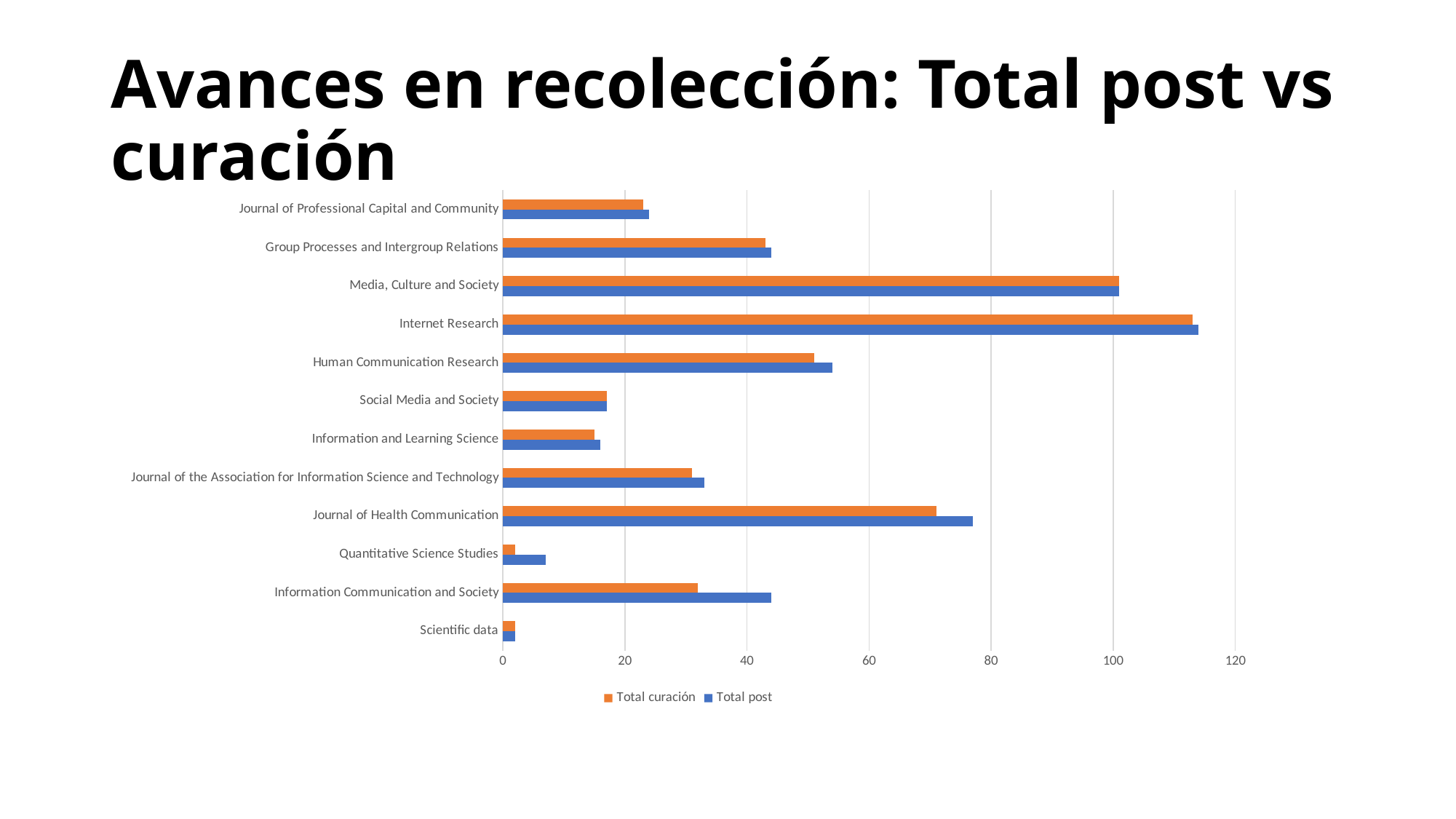
Which is larger: the Total post value for Human Communication Research or for Group Processes and Intergroup Relations? Human Communication Research Which journal has the highest Total curación value? Internet Research For Quantitative Science Studies, which is larger: Total post or Total curación? Total post Is the Total post value for Journal of Health Communication greater or less than 60? greater What kind of chart is shown on the slide? Bar chart Which colour represents the Total curación series? Orange Which journal has the lowest Total post value? Scientific data How many series does the legend list? 2 Is the Total curación value for Social Media and Society greater or less than 20? less Is the Total post value for Internet Research greater or less than 100? greater Which journal has the highest Total post value? Internet Research How many journals (categories) are plotted on the chart? 12